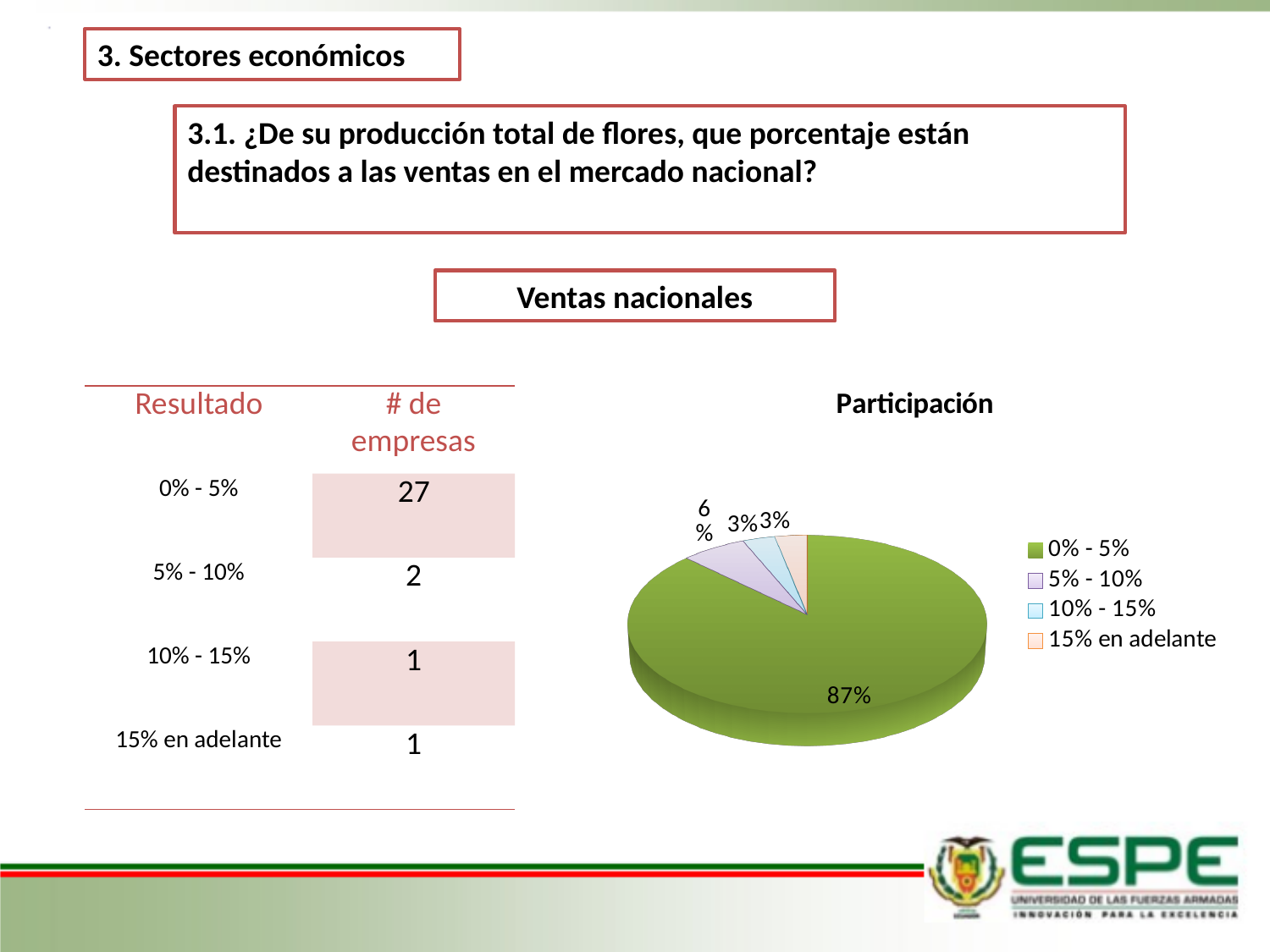
In the "Participación" pie chart, what share does the "0% - 5%" slice have? 87% In the "Participación" pie chart, what percentage is shown for the "5% - 10%" slice? 6% In the "Participación" pie chart, what percentage is shown for the "10% - 15%" slice? 3% In the "Participación" pie chart, what is the difference in percentage points between the "0% - 5%" slice and the "5% - 10%" slice? 81% Which category has the largest slice in the "Participación" pie chart? 0% - 5% How many entries does the legend of the "Participación" pie chart list? 4 What is the title of the pie chart on the slide? Participación How many slices does the "Participación" pie chart have? 4 In the "Participación" pie chart, which slice is larger: "5% - 10%" or "10% - 15%"? 5% - 10% In the "Participación" pie chart, what percentage is shown for the "15% en adelante" slice? 3% What colour is the largest slice in the "Participación" pie chart? green What type of chart is shown under the title "Participación"? pie chart